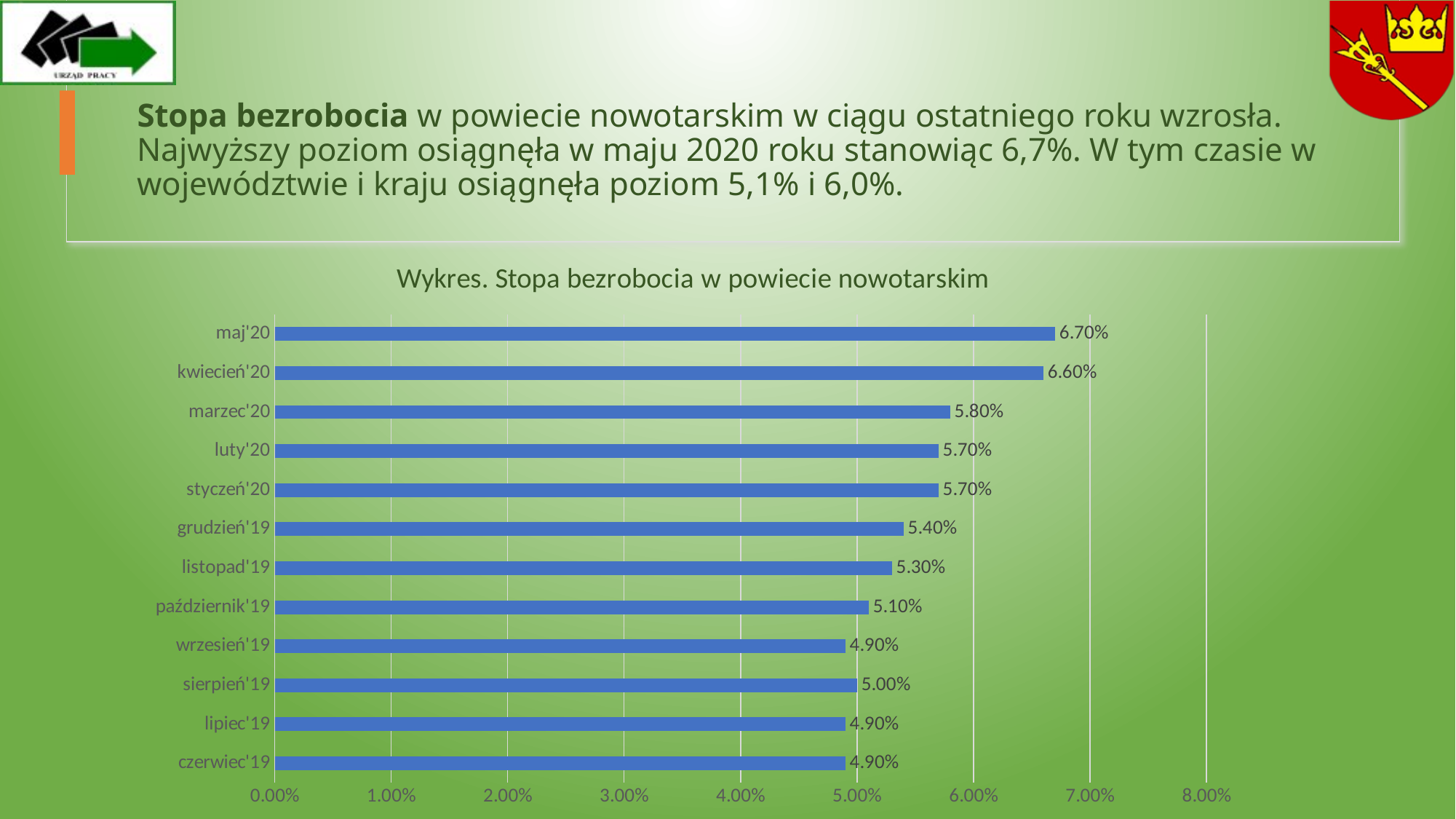
Is the value for marzec'20 greater or less than 6.00%? less Which month has the highest unemployment rate on the chart? maj'20 What is the difference between the values for kwiecień'20 and marzec'20? 0.80% What is the title of the chart? Wykres. Stopa bezrobocia w powiecie nowotarskim What kind of chart is shown on the slide? bar chart Which is larger, the value for listopad'19 or the value for sierpień'19? listopad'19 What is the value shown for październik'19? 5.10% How many months are shown on the chart? 12 What is the difference between the values for maj'20 and czerwiec'19? 1.80% What is the value shown for grudzień'19? 5.40% What is the highest value shown on the horizontal axis? 8.00% What is the unemployment rate shown for maj'20? 6.70%